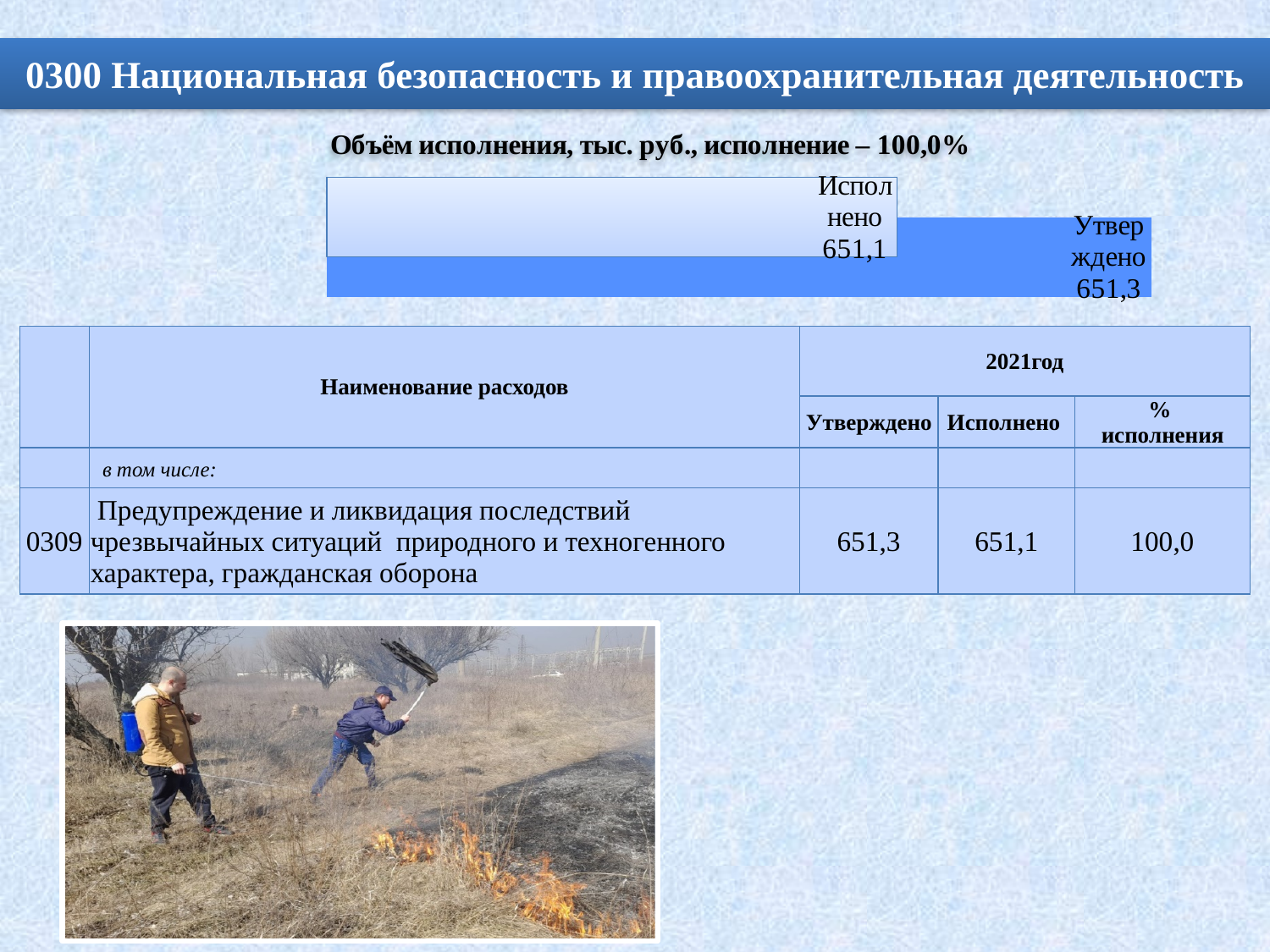
What is the difference between the Утверждено and Исполнено values in the bar chart? 0,2 What value is shown for Утверждено in the bar chart? 651,3 What kind of chart is shown on the slide? bar chart What is the title of the chart on the slide? Объём исполнения, тыс. руб., исполнение – 100,0% How many bars are plotted in the chart? 2 Which category has the lowest value in the bar chart? Исполнено What value is shown for Исполнено in the bar chart? 651,1 What unit of measurement does the chart title state for the values? тыс. руб. Which bar in the chart has the higher value, Утверждено or Исполнено? Утверждено Which category has the highest value in the bar chart? Утверждено